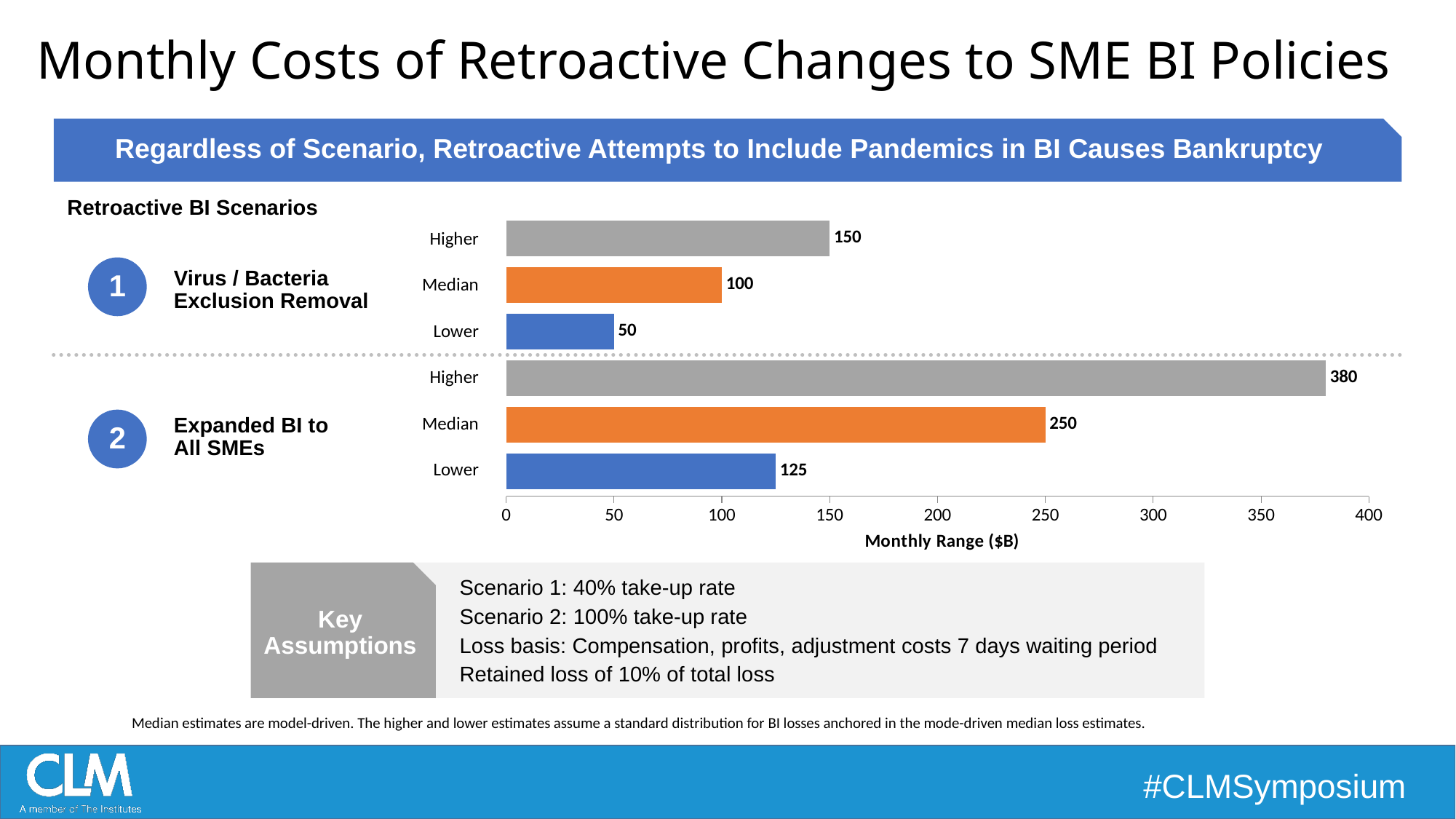
What is the Higher estimate for Scenario 1 (Virus / Bacteria Exclusion Removal)? 150 How many bars are plotted on the chart? 6 Which bar has the highest value on the chart? Scenario 2 Higher (380) What kind of chart is shown on the slide? Bar chart What is the difference between the Median and Lower estimates for Scenario 1? 50 What is the Median estimate for Scenario 2 (Expanded BI to All SMEs)? 250 What is the Lower estimate for Scenario 2 (Expanded BI to All SMEs)? 125 Is the Higher estimate for Scenario 2 greater or less than 350? greater What is the difference between the Higher estimates of Scenario 2 and Scenario 1? 230 Which is larger: the Lower estimate for Scenario 2 or the Median estimate for Scenario 1? Lower estimate for Scenario 2 (125) What is the label of the horizontal axis of the chart? Monthly Range ($B) Which bar has the lowest value on the chart? Scenario 1 Lower (50)